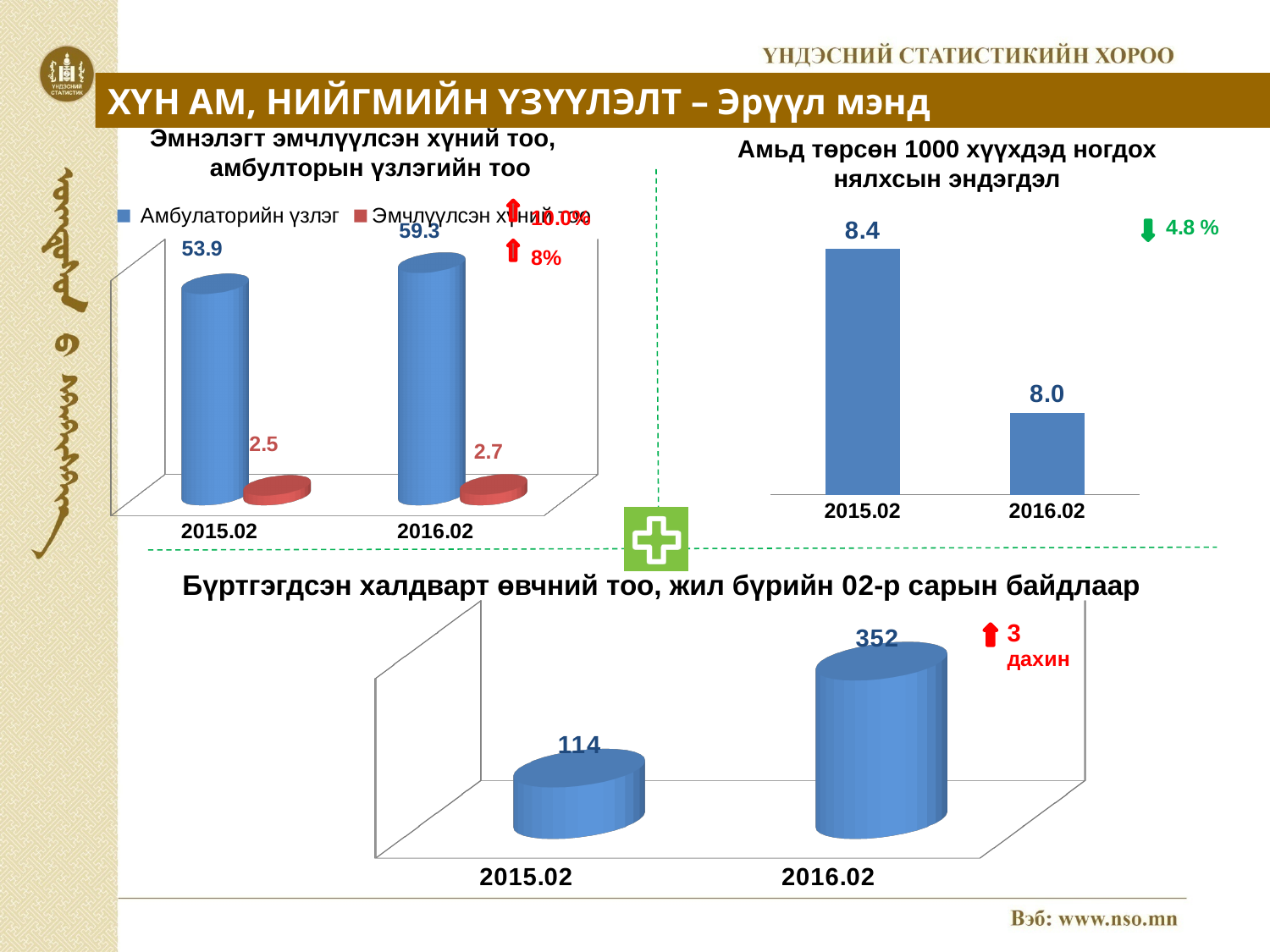
In the chart titled 'Амьд төрсөн 1000 хүүхдэд ногдох нялхсын эндэгдэл', which year has the lower value? 2016.02 In the top-left chart, which series is shown in red? Эмчлүүлсэн хүний тоо What type of chart is the bottom chart? bar chart In the bottom chart, what is the difference between the values for 2016.02 and 2015.02? 238 In the top-left chart, what is the difference between the Амбулаторийн үзлэг values for 2016.02 and 2015.02? 5.4 In the bottom chart, what is the value for 2016.02? 352 In the top-left chart, what is the value of Эмчлүүлсэн хүний тоо for 2015.02? 2.5 In the chart titled 'Амьд төрсөн 1000 хүүхдэд ногдох нялхсын эндэгдэл', what is the value for 2015.02? 8.4 In the bottom chart, which year has the higher value? 2016.02 In the chart titled 'Амьд төрсөн 1000 хүүхдэд ногдох нялхсын эндэгдэл', do the values rise or fall from 2015.02 to 2016.02? fall In the top-left chart, what is the value of Амбулаторийн үзлэг for 2016.02? 59.3 How many series does the legend of the top-left chart list? 2